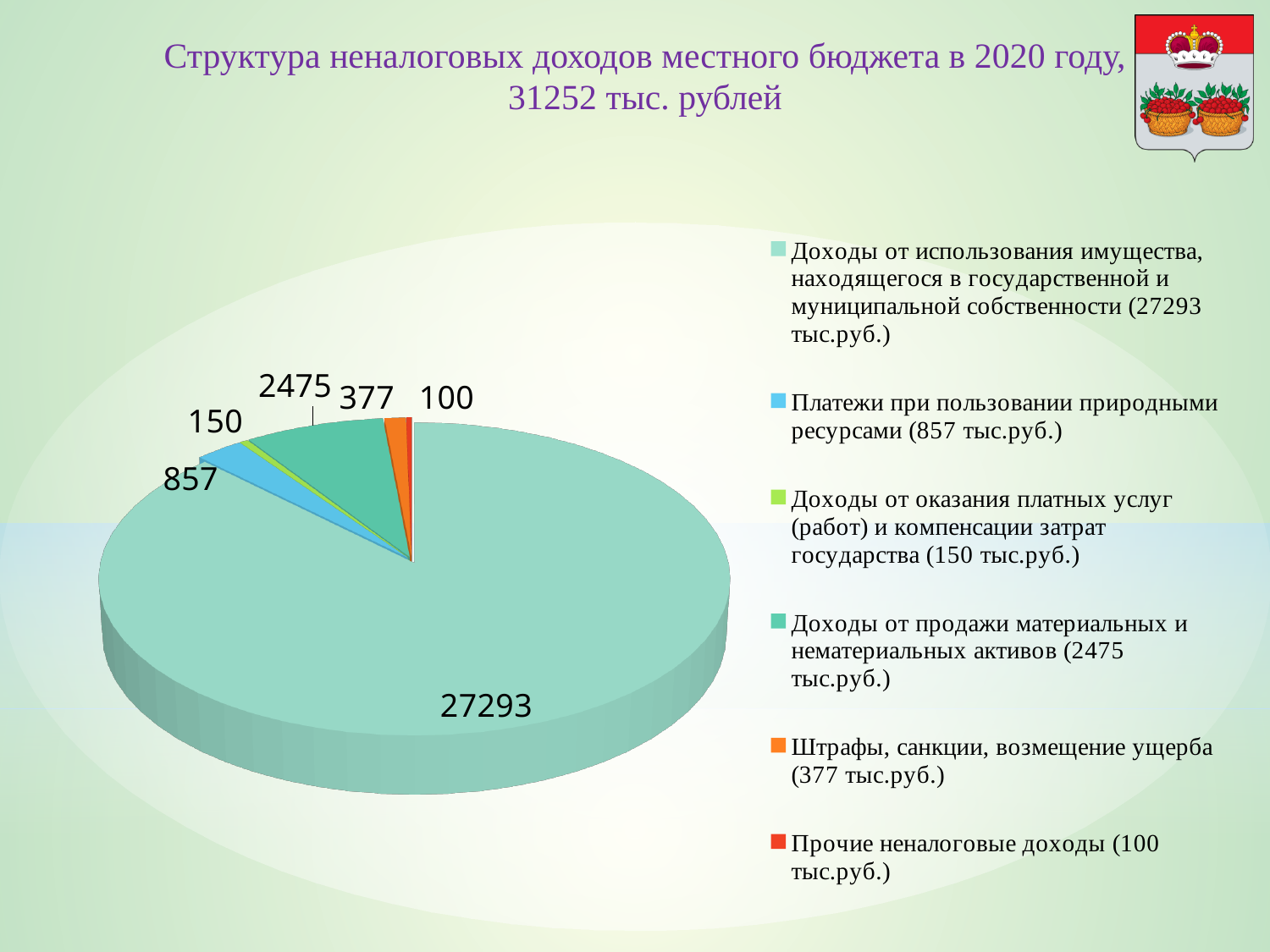
What is the value of the slice for "Доходы от использования имущества, находящегося в государственной и муниципальной собственности"? 27293 Which is larger: the value for "Штрафы, санкции, возмещение ущерба" or the value for "Доходы от оказания платных услуг (работ) и компенсации затрат государства"? Штрафы, санкции, возмещение ущерба What is the title of the chart on the slide? Структура неналоговых доходов местного бюджета в 2020 году, 31252 тыс. рублей Which category has the largest slice in the pie chart? Доходы от использования имущества, находящегося в государственной и муниципальной собственности How many slices does the pie chart have? 6 What is the value of the slice for "Штрафы, санкции, возмещение ущерба"? 377 What kind of chart is shown on the slide? Pie chart What is the value of the slice for "Доходы от продажи материальных и нематериальных активов"? 2475 What is the value of the slice for "Платежи при пользовании природными ресурсами"? 857 Which category has the smallest slice in the pie chart? Прочие неналоговые доходы What is the difference between the values for "Доходы от продажи материальных и нематериальных активов" and "Платежи при пользовании природными ресурсами"? 1618 How many entries does the legend list? 6